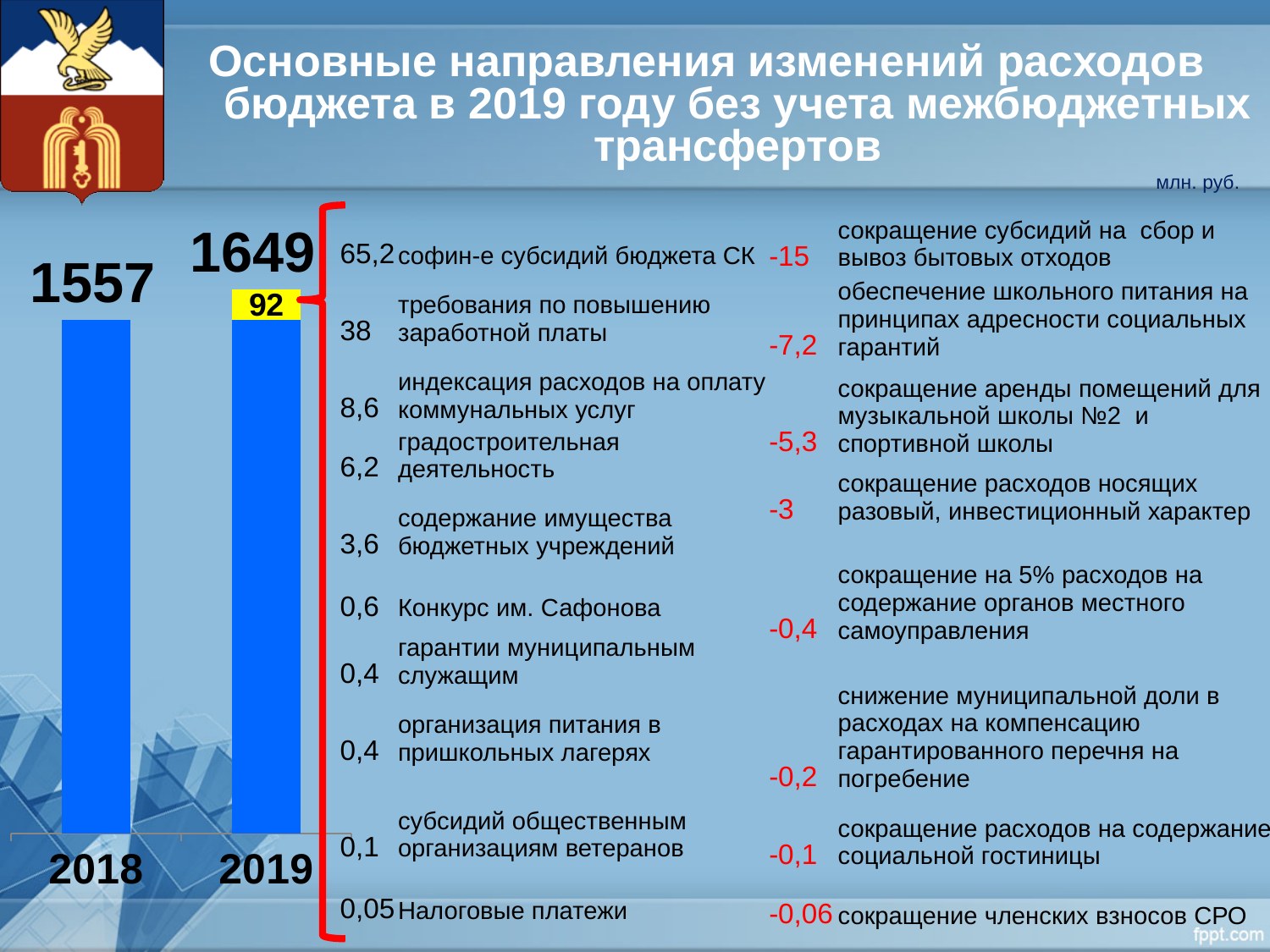
What colour is the segment labelled 92 on the 2019 bar? yellow Is the value for 2019 larger or smaller than the value for 2018? larger What is the value shown for 2019 in the bar chart? 1649 What is the difference between the 2019 value and the 2018 value in the bar chart? 92 Which year has the higher bar in the chart? 2019 Which year has the lower bar in the chart? 2018 What value is printed on the yellow segment at the top of the 2019 bar? 92 How many bars are shown in the chart? 2 What unit of measurement is indicated for the chart values? млн. руб. What is the value shown for 2018 in the bar chart? 1557 Do the values rise or fall from 2018 to 2019? rise What kind of chart is shown on the slide? bar chart